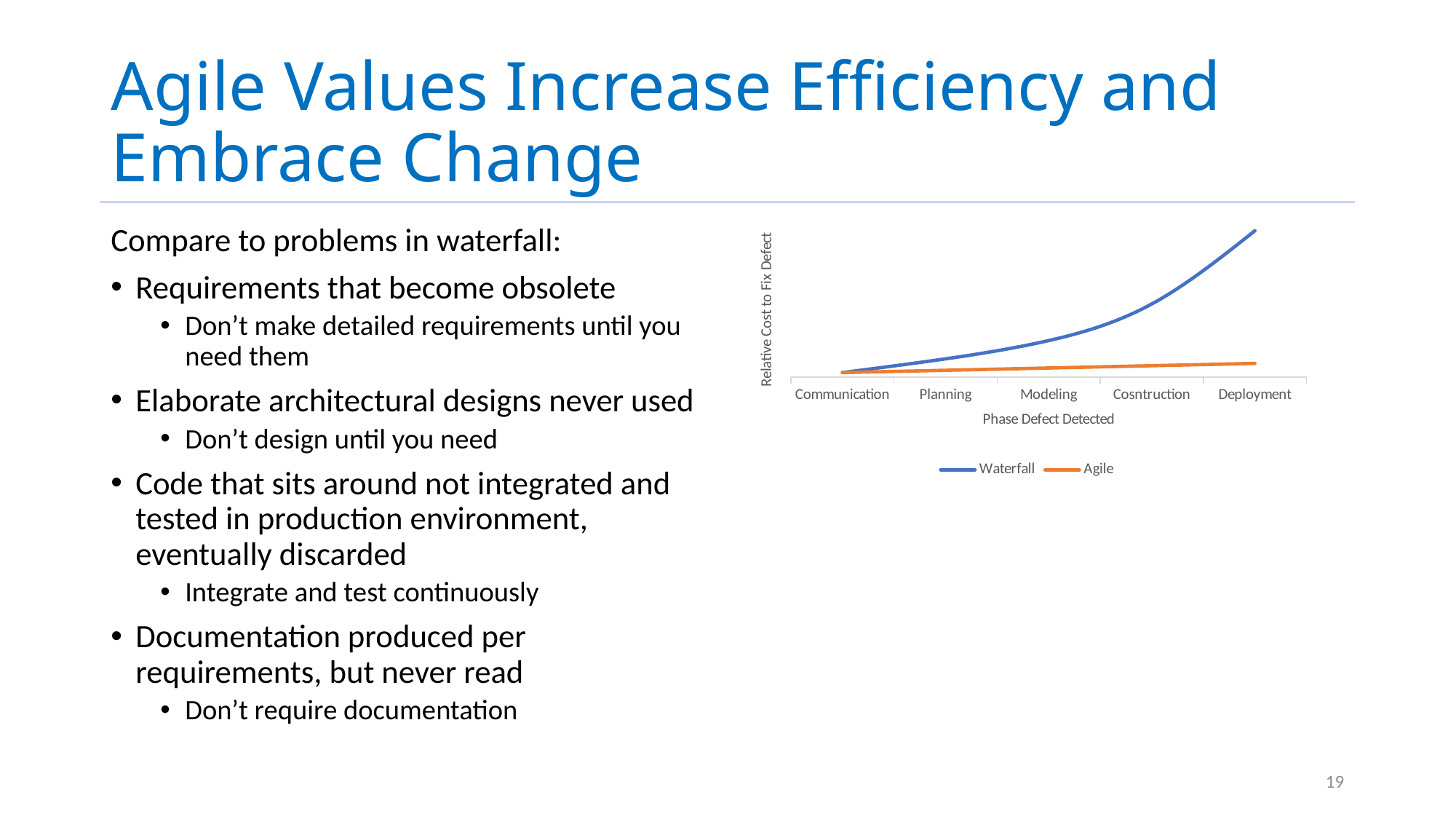
Which series shows the steeper increase across the phases, Waterfall or Agile? Waterfall At which phase is the Waterfall series at its lowest relative cost to fix a defect? Communication How many series does the chart's legend list? 2 Which phase is listed first on the x axis of the chart? Communication Does the Waterfall line rise or fall from Communication to Deployment? rise At the Deployment phase, which series has the higher relative cost to fix a defect, Waterfall or Agile? Waterfall What is the title of the chart's x axis? Phase Defect Detected Which series does the chart's legend list besides Waterfall? Agile How many phases are shown along the x axis of the chart? 5 What kind of chart is shown on the slide? line chart At which phase does the Waterfall series reach its highest relative cost to fix a defect? Deployment